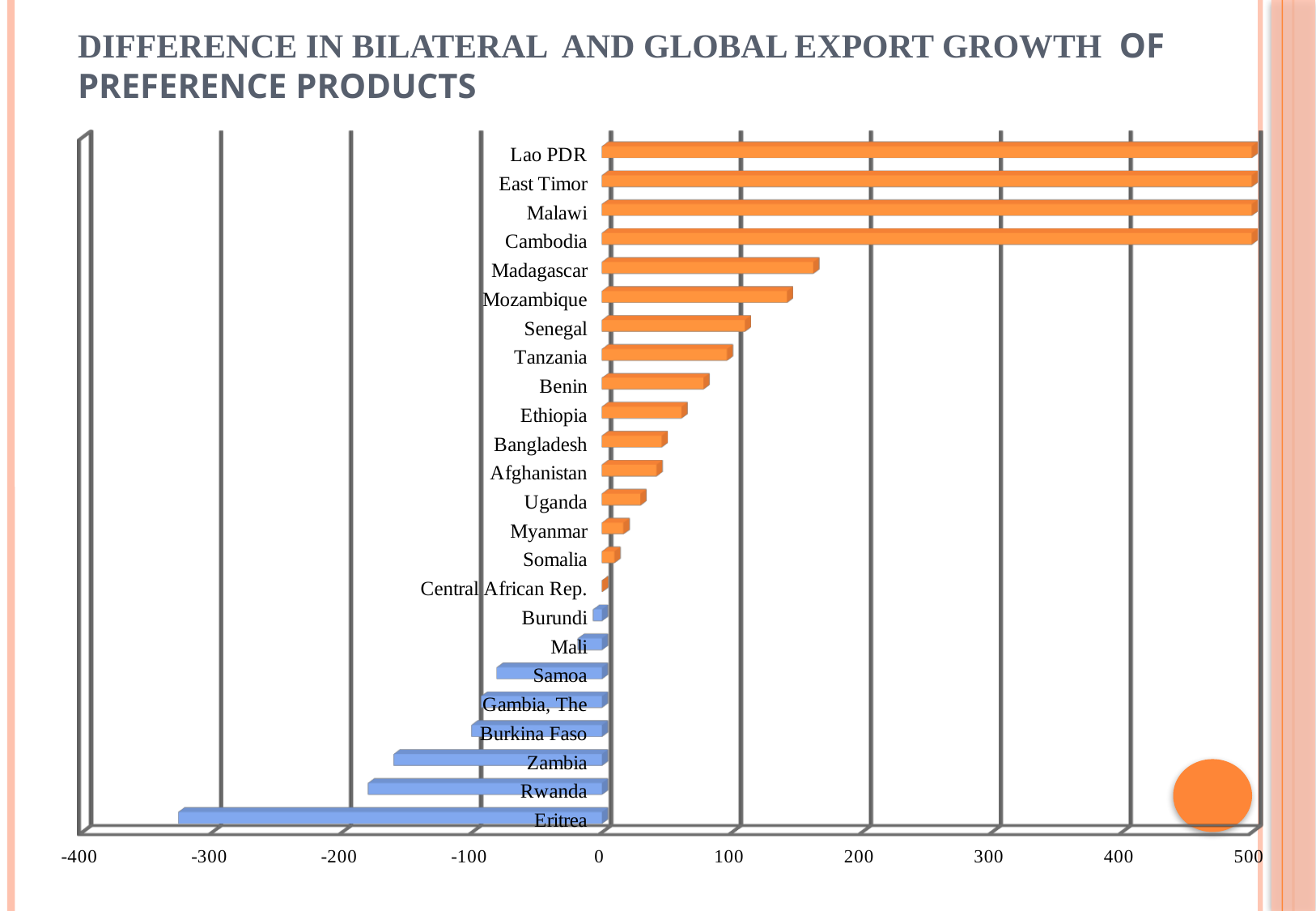
Is the value for Benin greater or less than 100? less Is the value for Eritrea greater or less than -300? less Which has the larger value, Madagascar or Benin? Madagascar Is the value for Samoa greater or less than -100? greater Which has the larger value, Rwanda or Eritrea? Rwanda Which country has the lowest value in the chart? Eritrea What colour are the bars for countries with negative values? blue What kind of chart is shown on the slide? bar chart How many countries are plotted in the chart? 24